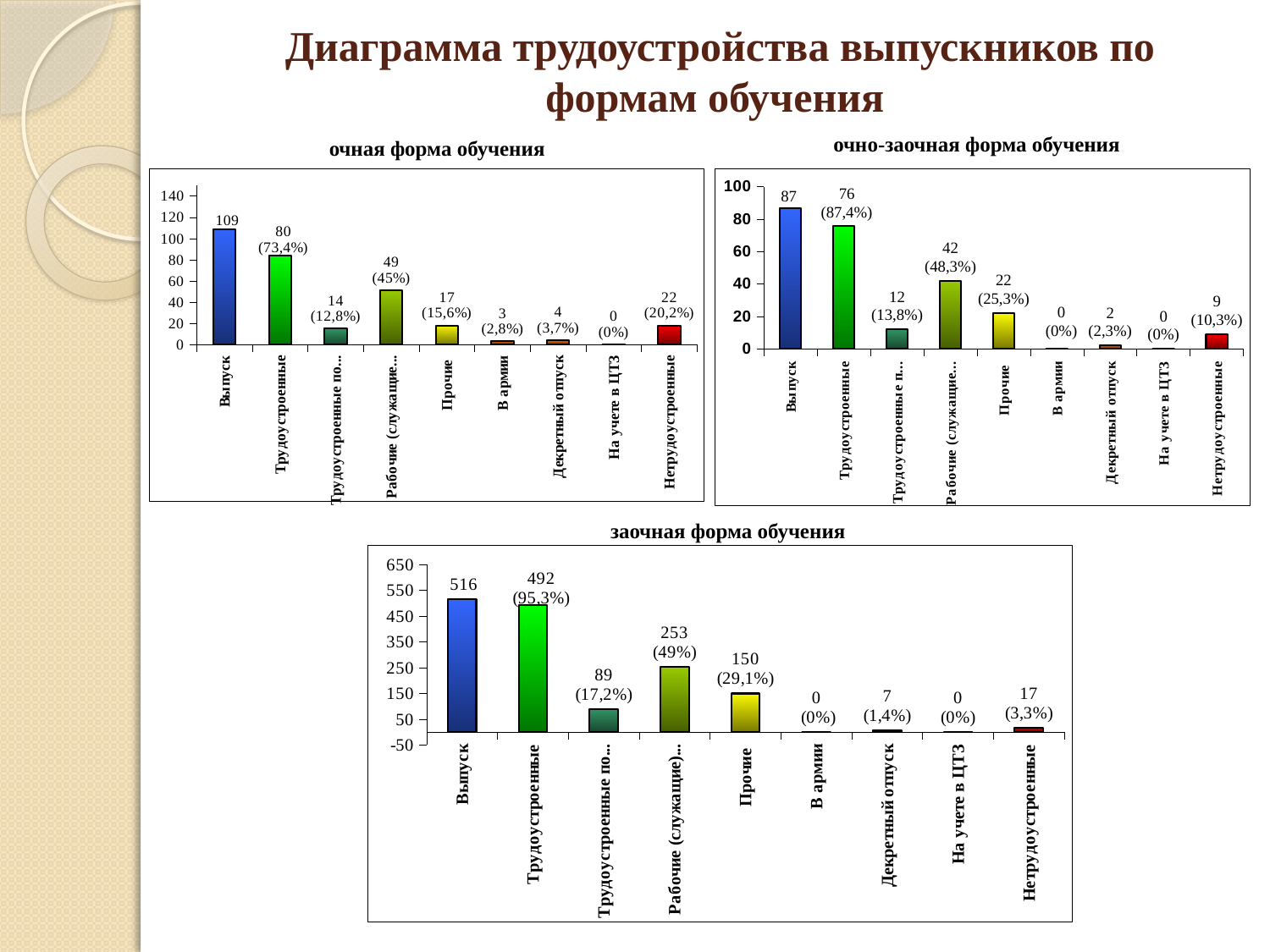
What kind of chart is the chart titled "заочная форма обучения"? bar chart In the chart titled "очная форма обучения", what is the difference between Выпуск and Трудоустроенные? 29 How many categories are shown in the chart titled "очно-заочная форма обучения"? 9 In the chart titled "очно-заочная форма обучения", which is larger: Прочие or Нетрудоустроенные? Прочие In the chart titled "заочная форма обучения", which category has the highest value? Выпуск In the chart titled "заочная форма обучения", what is the difference between Трудоустроенные and Рабочие (служащие)? 239 In the chart titled "заочная форма обучения", what is the value for Прочие? 150 In the chart titled "очно-заочная форма обучения", what is the value for Трудоустроенные? 76 In the chart titled "очная форма обучения", what is the value for Декретный отпуск? 4 What is the title of the chart at the bottom of the slide? заочная форма обучения In the chart titled "очная форма обучения", what is the value for Выпуск? 109 In the chart titled "очная форма обучения", what is the value for Нетрудоустроенные? 22